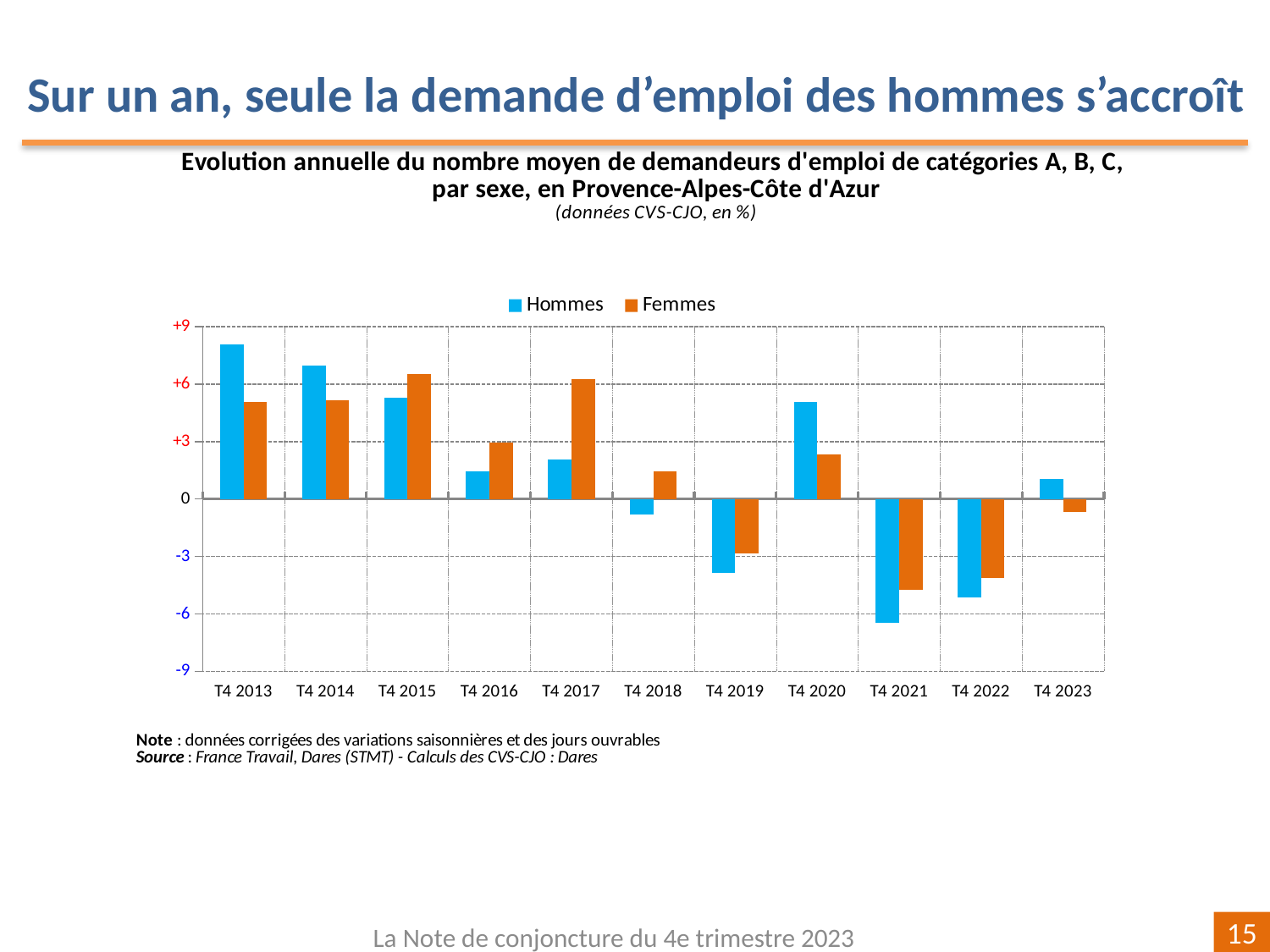
Which colour represents the Femmes series in the chart? orange What kind of chart is shown on the slide? bar chart For T4 2017, which series has the larger value, Hommes or Femmes? Femmes Is the Hommes value for T4 2013 greater or less than +6? greater For T4 2023, which series has the larger value, Hommes or Femmes? Hommes How many series does the legend list? 2 In which quarter is the Hommes value lowest? T4 2021 In which quarter is the Hommes value highest? T4 2013 How many quarters (categories) are shown on the x axis? 11 Is the Hommes value for T4 2021 greater or less than -6? less Is the Femmes value for T4 2020 greater or less than +3? less In which quarter is the Femmes value lowest? T4 2021